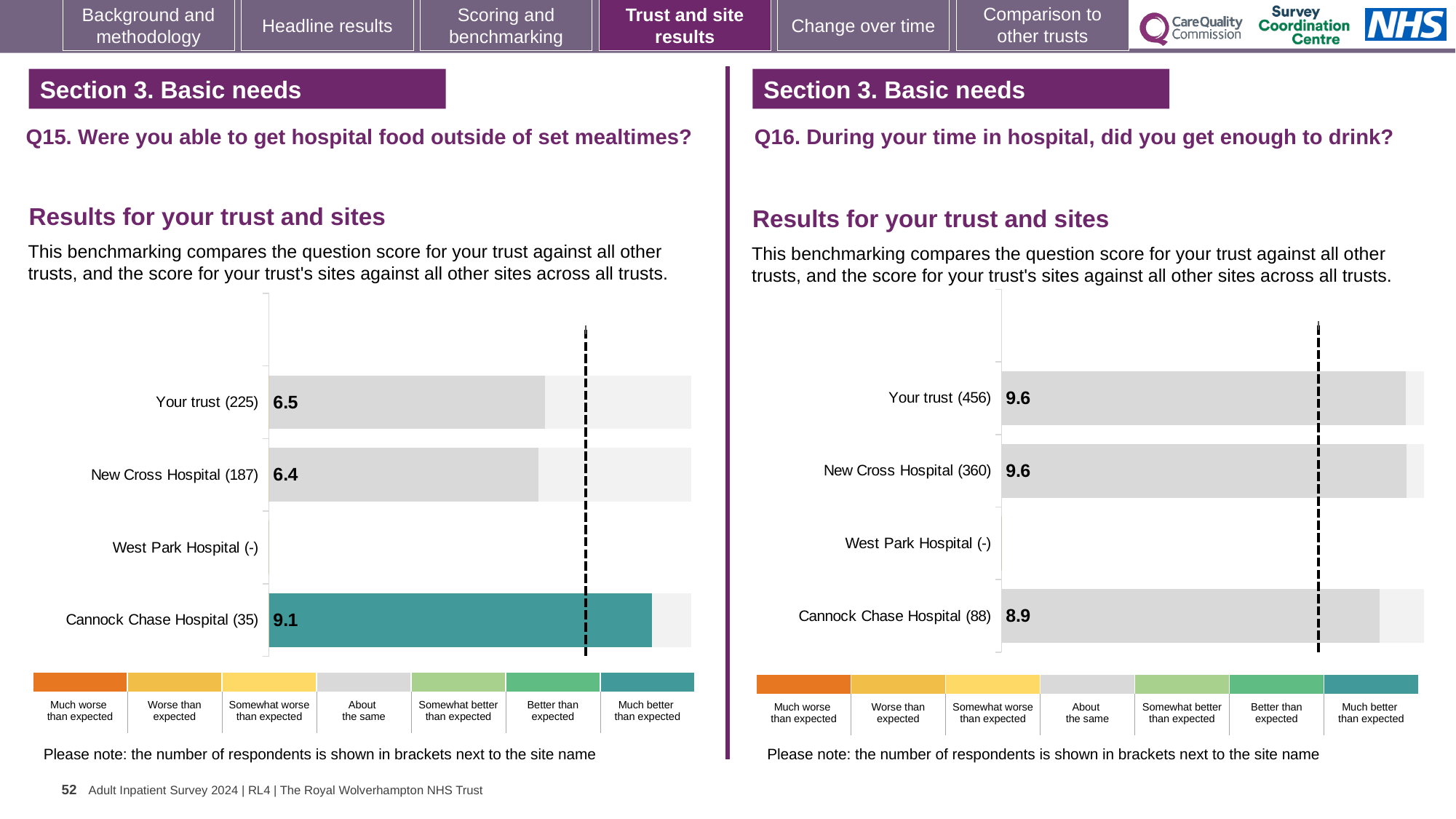
On the Q15 chart (left), what is the score for Cannock Chase Hospital (35)? 9.1 On the Q15 chart (left), what is the score for Your trust (225)? 6.5 On the Q15 chart (left), which has the larger score: New Cross Hospital or Cannock Chase Hospital? Cannock Chase Hospital What kind of chart is used for the Q15 results (left)? Bar chart On the Q15 chart (left), what is the difference between the scores for Cannock Chase Hospital and Your trust? 2.6 On the Q15 chart (left), which benchmark category does the colour of the Cannock Chase Hospital bar correspond to? Much better than expected On the Q15 chart (left), which site or trust has the highest score? Cannock Chase Hospital (35) On the Q16 chart (right), which site or trust has the lowest score shown? Cannock Chase Hospital (88) On the Q16 chart (right), what is the score for Cannock Chase Hospital (88)? 8.9 How many sites or trusts are listed on the Q16 chart (right)? 4 On the Q16 chart (right), what is the difference between the scores for Your trust and Cannock Chase Hospital? 0.7 On the Q16 chart (right), what is the score for New Cross Hospital (360)? 9.6